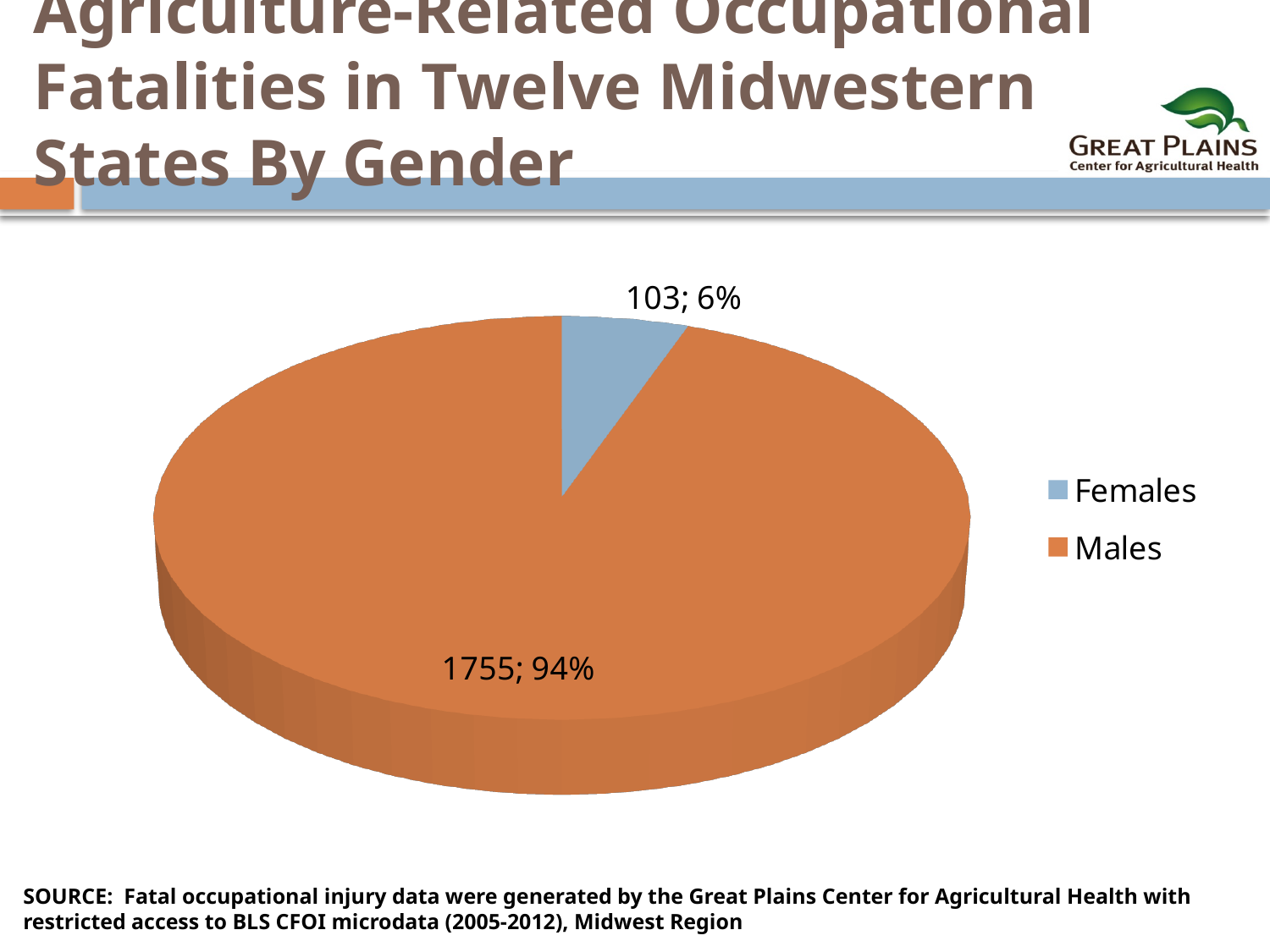
What percentage of the pie does the Males slice represent? 94% What percentage of the pie does the Females slice represent? 6% How many fatalities are shown for Males? 1755 Which category has the smallest slice of the pie? Females Which is larger, the value for Males or the value for Females? Males Which category has the largest slice of the pie? Males How many fatalities are shown for Females? 103 What colour is the Females slice in the pie chart? blue What kind of chart is shown on the slide? pie chart What is the difference between the number of fatalities for Males and Females? 1652 What is the total number of fatalities shown across both slices? 1858 How many categories does the pie chart have? 2